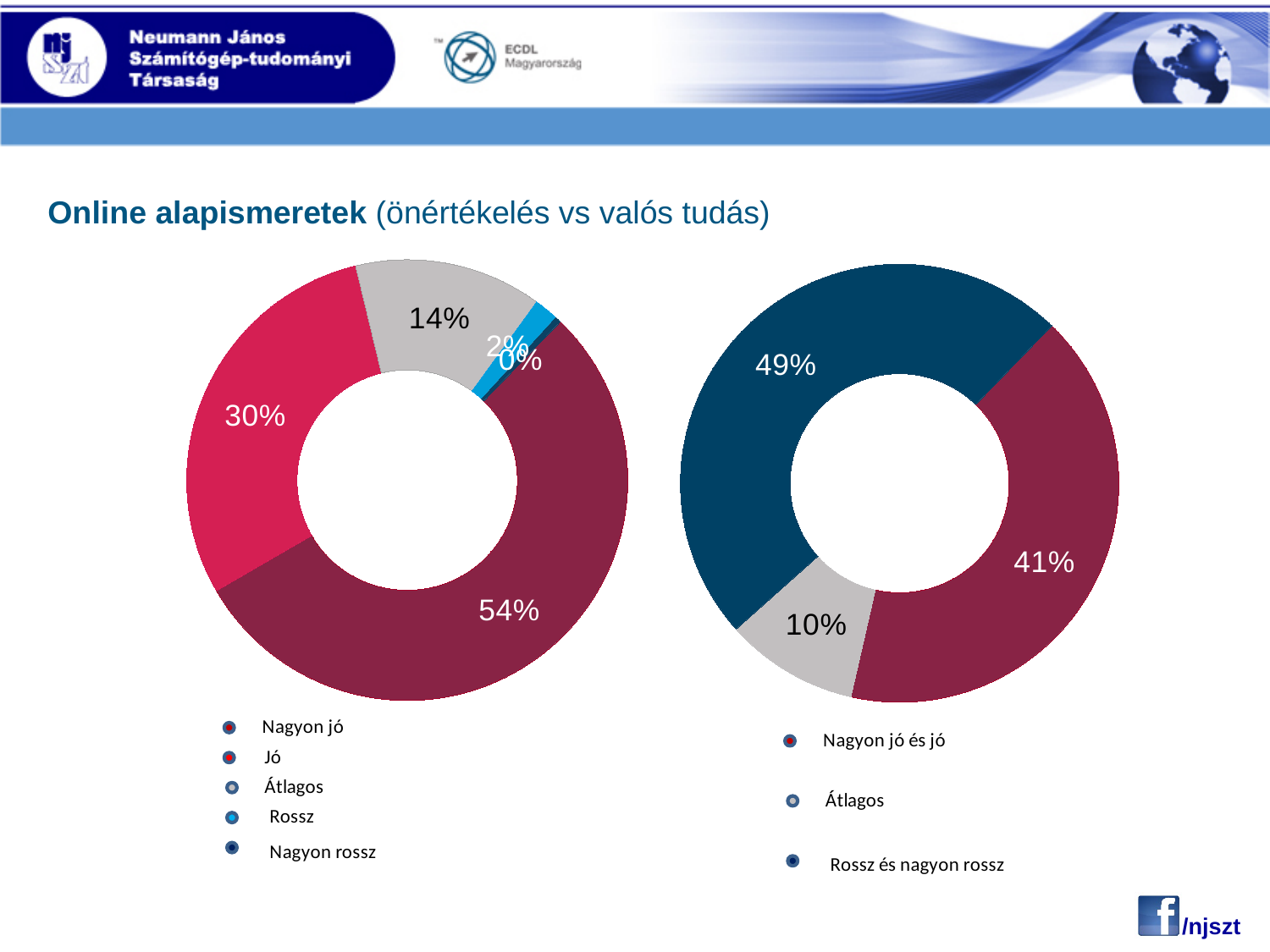
In the left chart, what is the difference between the 54% slice and the 30% slice? 24 percentage points In the right chart, which is larger: the Nagyon jó és jó slice or the Átlagos slice? Nagyon jó és jó In the right chart, which slice is the largest? Rossz és nagyon rossz (49%) What is the title of the slide? Online alapismeretek (önértékelés vs valós tudás) In the right chart, what is the difference between the 49% slice and the 41% slice? 8 percentage points In the left chart, what is the largest slice's value? 54% In the right chart, what percentage is shown for Átlagos (grey slice)? 10% How many categories does the legend of the left chart list? 5 In the left chart, what is the value of the smallest slice? 0% What kind of chart is shown on the left of the slide? Pie (donut) chart In the left chart, what percentage is shown for the grey slice (Átlagos)? 14% How many slices does the right chart have? 3